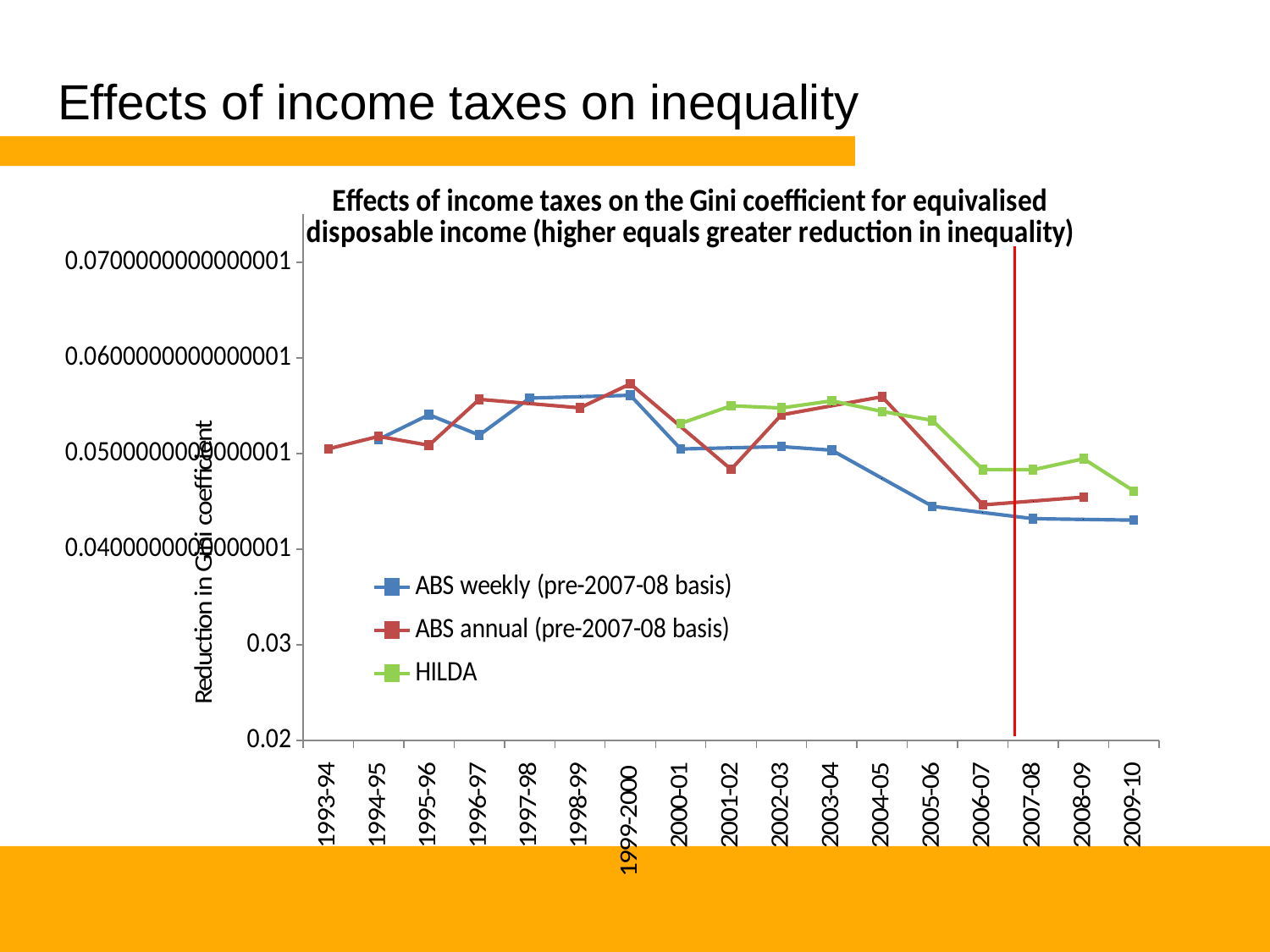
Which series are listed in the legend? ABS weekly (pre-2007-08 basis), ABS annual (pre-2007-08 basis), HILDA How many series does the legend list? 3 In 2006-07, which series has the higher value: HILDA or ABS annual (pre-2007-08 basis)? HILDA Is the value for ABS weekly (pre-2007-08 basis) in 2009-10 greater or less than 0.04? greater What kind of chart is shown on the slide? line chart In 2009-10, which series has the higher value: HILDA or ABS weekly (pre-2007-08 basis)? HILDA Does the ABS weekly (pre-2007-08 basis) series rise or fall from 2003-04 to 2009-10? fall How many years are shown along the x axis? 17 Is the value for ABS annual (pre-2007-08 basis) in 1999-2000 greater or less than 0.05? greater What is the label of the vertical axis? Reduction in Gini coefficient Is the value for ABS annual (pre-2007-08 basis) in 2001-02 greater or less than 0.05? less